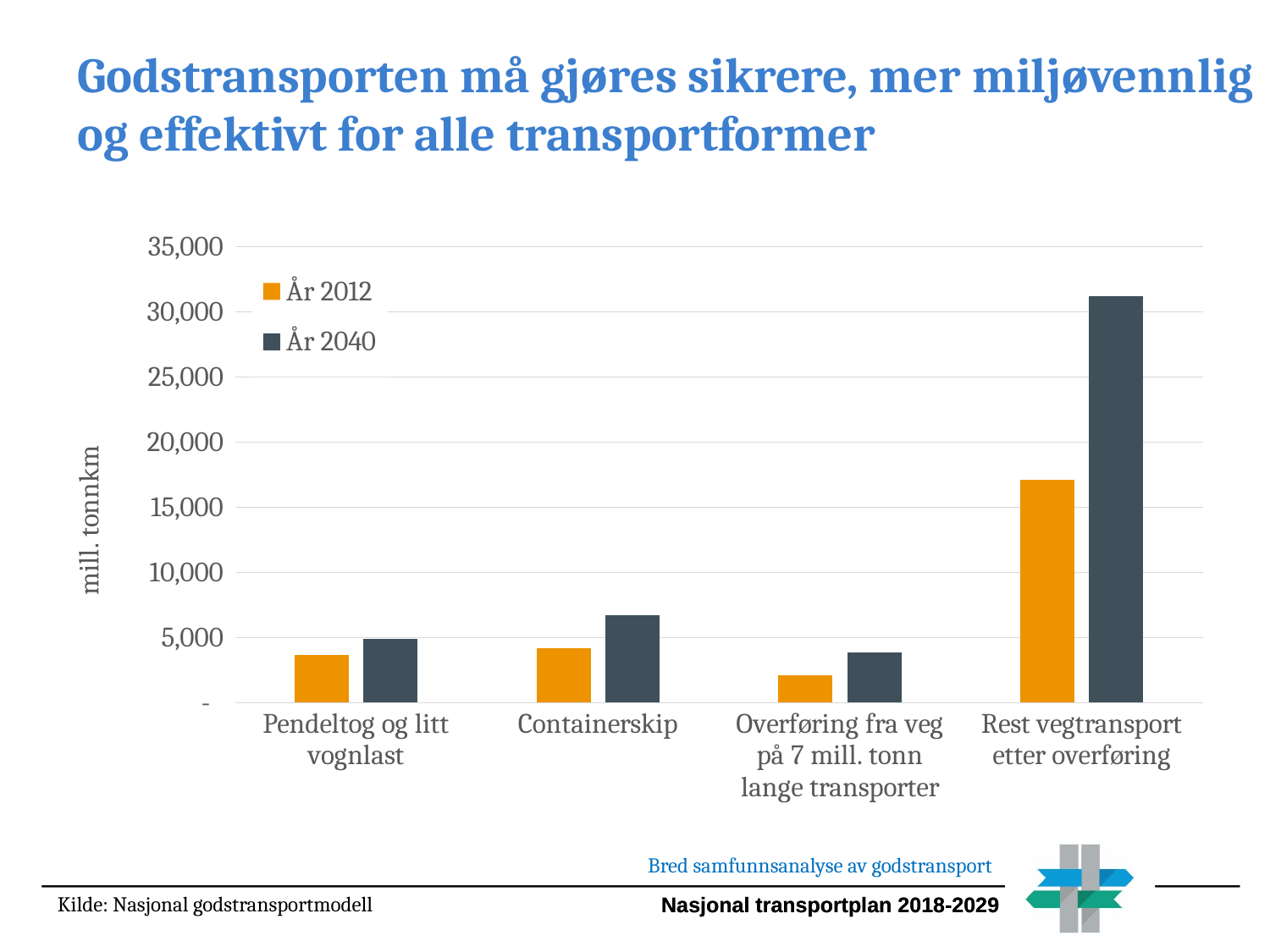
How many series does the legend list? 2 For each category, is the År 2040 value higher or lower than the År 2012 value? higher Is the År 2040 value for Containerskip greater or less than 5,000? greater Is the År 2012 value for Rest vegtransport etter overføring greater or less than 15,000? greater Is the År 2040 value for Rest vegtransport etter overføring greater or less than 30,000? greater Which is larger for År 2040: Containerskip or Pendeltog og litt vognlast? Containerskip Which category has the highest value for År 2040? Rest vegtransport etter overføring What is the label on the y axis? mill. tonnkm How many categories are shown on the x axis? 4 What kind of chart is shown on the slide? bar chart Which category has the lowest value for År 2012? Overføring fra veg på 7 mill. tonn lange transporter